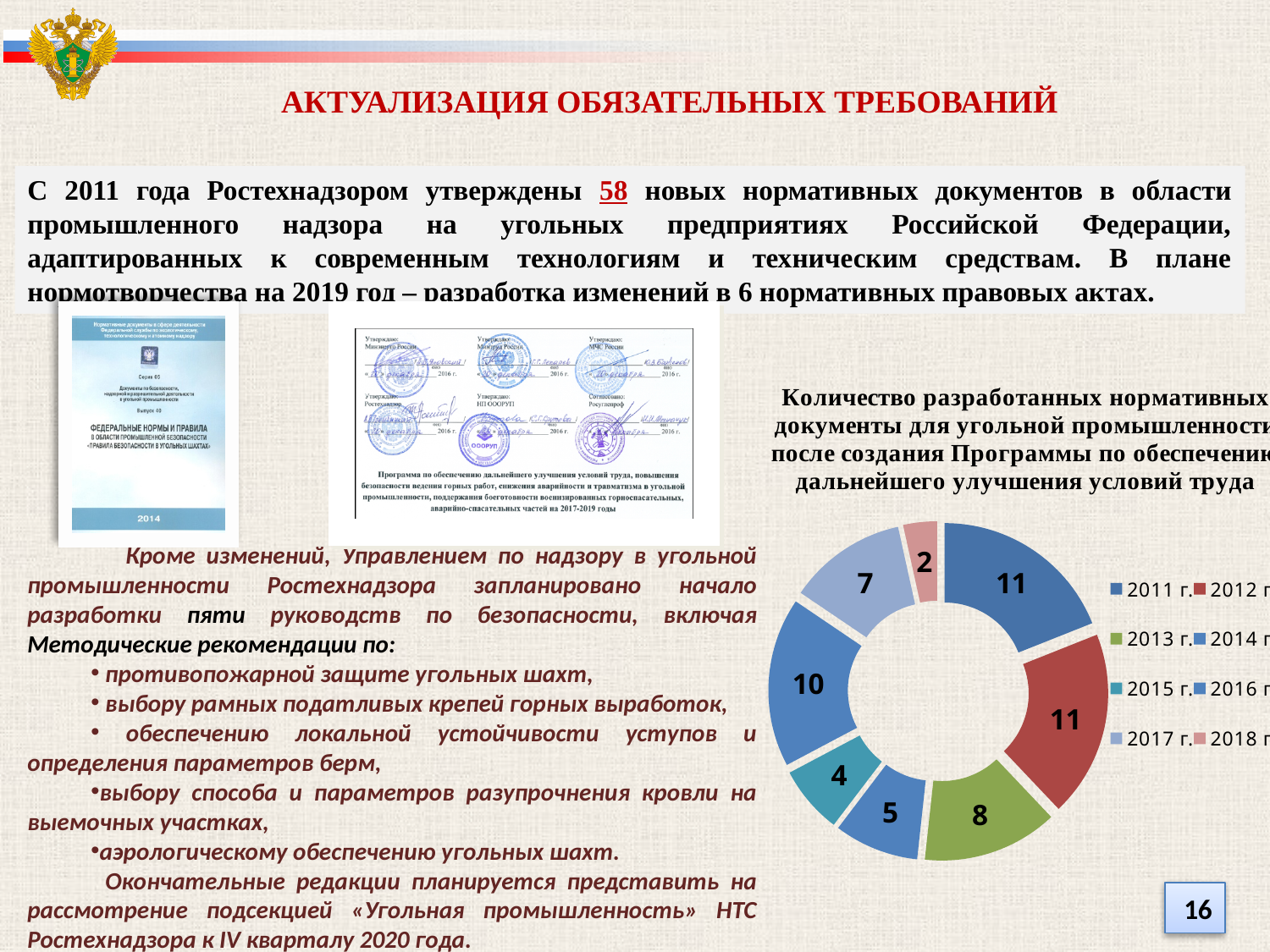
What is the difference between the values for 2016 г. and 2017 г.? 3 Which year has the lowest value in the doughnut chart? 2018 г. What type of chart is shown on the slide? Doughnut (pie) chart What is the total of all segments in the doughnut chart? 58 Which is larger, the value for 2013 г. or the value for 2014 г.? 2013 г. How many entries does the legend of the doughnut chart list? 8 What is the value for 2014 г. in the doughnut chart? 5 What is the value for 2015 г. in the doughnut chart? 4 What is the value for 2018 г. in the doughnut chart? 2 How many segments does the doughnut chart have? 8 What is the value for 2016 г. in the doughnut chart? 10 What is the value for 2013 г. in the doughnut chart? 8